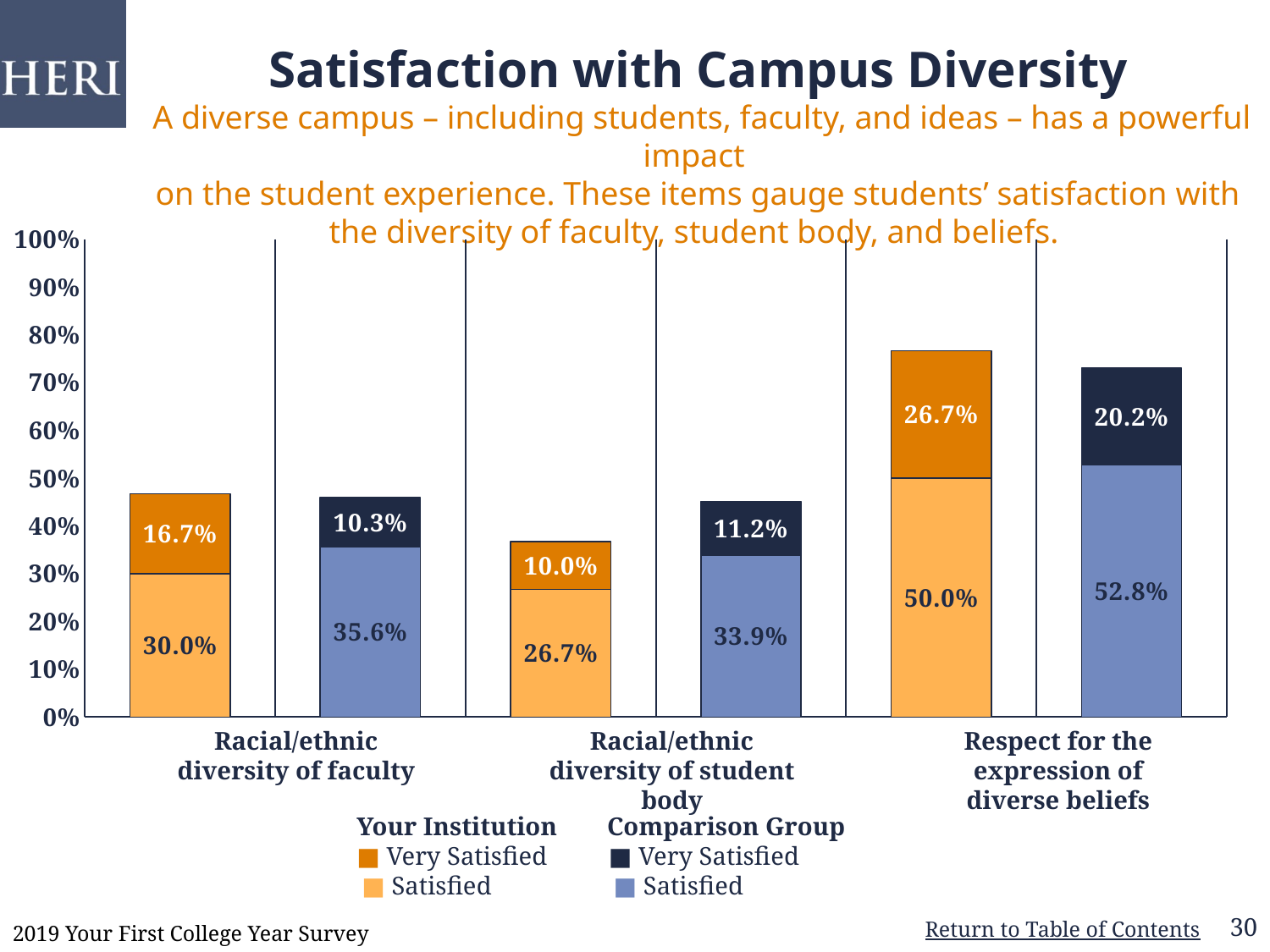
What is the total percentage (Satisfied plus Very Satisfied) for the Comparison Group on racial/ethnic diversity of faculty? 45.9% What is the total percentage (Satisfied plus Very Satisfied) for Your Institution on respect for the expression of diverse beliefs? 76.7% Which item has the lowest Very Satisfied percentage for Your Institution? Racial/ethnic diversity of student body What percentage of Your Institution students were Very Satisfied with the racial/ethnic diversity of faculty? 16.7% How many items (categories) are shown on the x axis of the chart? 3 Which item has the highest Very Satisfied percentage for Your Institution? Respect for the expression of diverse beliefs What percentage of the Comparison Group were Satisfied with the racial/ethnic diversity of the student body? 33.9% What kind of chart is shown on the slide? Stacked bar chart What percentage of Your Institution students were Satisfied with respect for the expression of diverse beliefs? 50.0% How many entries does the chart legend list? 4 What is the difference between the Comparison Group's Satisfied value and Your Institution's Satisfied value for racial/ethnic diversity of the student body? 7.2% For respect for the expression of diverse beliefs, which group has the larger Very Satisfied percentage, Your Institution or the Comparison Group? Your Institution